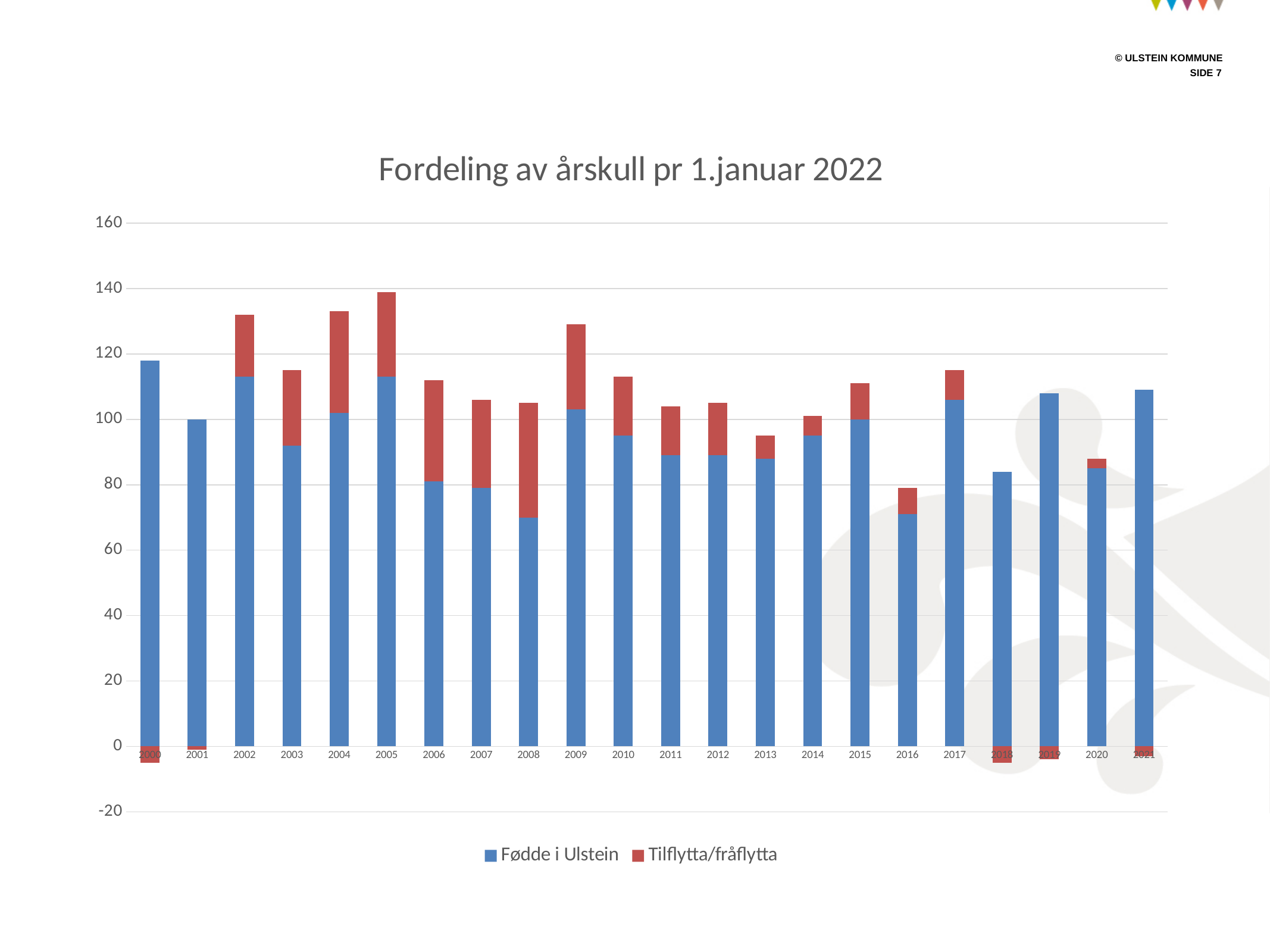
Is the total stacked bar for 2005 greater or less than 120? greater Which year has the highest value for Fødde i Ulstein? 2000 Is the value for Fødde i Ulstein in 2016 greater or less than 80? less What is the title of the chart? Fordeling av årskull pr 1.januar 2022 How many years are shown along the x axis? 22 Which series is shown in red? Tilflytta/fråflytta Which year has the tallest stacked bar overall? 2005 How many series does the legend list? 2 What kind of chart is shown on the slide? bar chart Which year has the larger total stacked bar, 2009 or 2010? 2009 Is the value for Fødde i Ulstein in 2021 greater or less than 100? greater